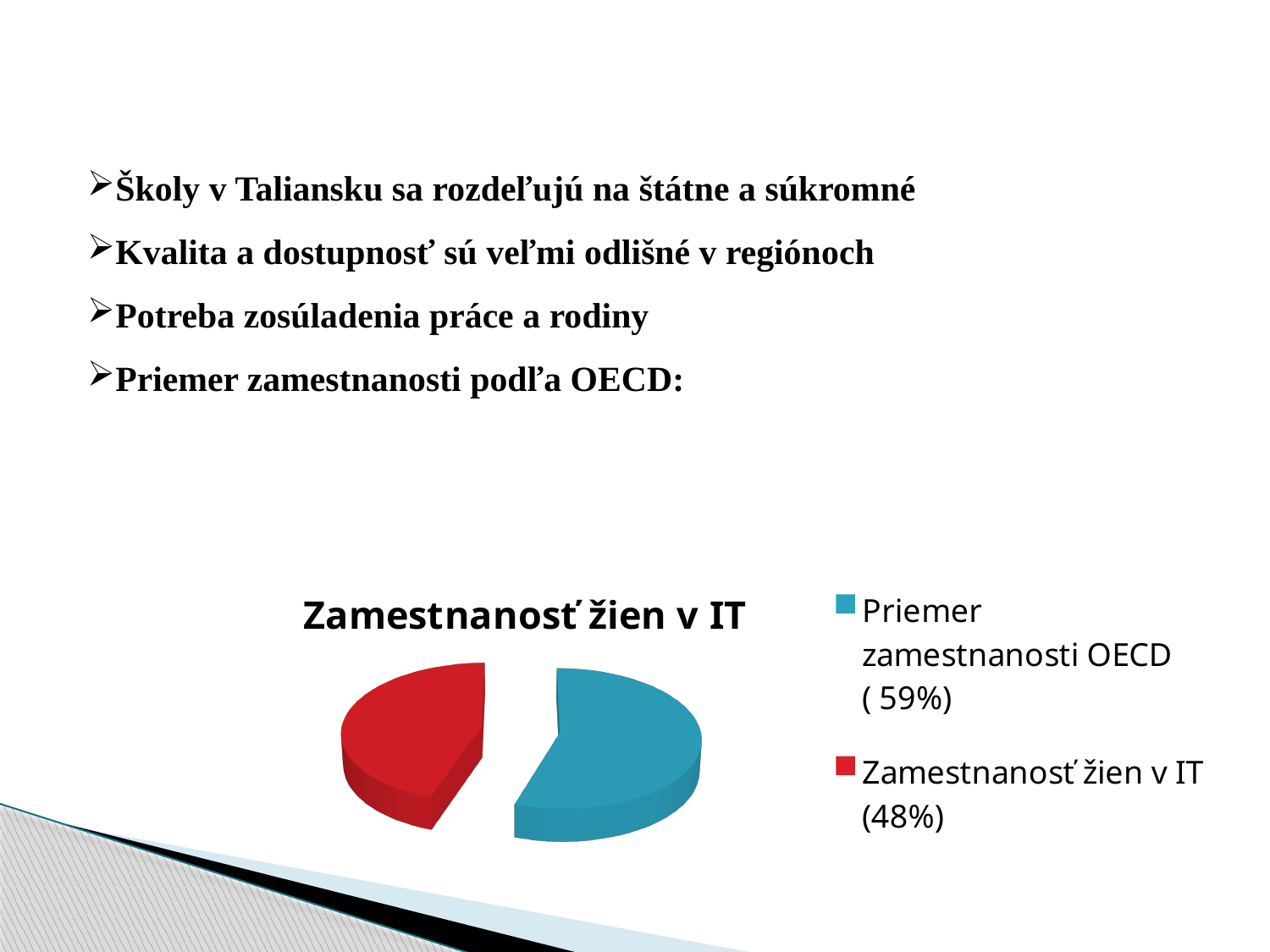
Which slice of the pie chart is the largest? Priemer zamestnanosti OECD What percentage is given in the legend for "Priemer zamestnanosti OECD"? 59% What percentage is given in the legend for "Zamestnanosť žien v IT"? 48% What is the title of the chart? Zamestnanosť žien v IT Which slice of the pie chart is the smallest? Zamestnanosť žien v IT Which legend entry has the larger value, "Priemer zamestnanosti OECD" or "Zamestnanosť žien v IT"? Priemer zamestnanosti OECD What colour is the slice for "Zamestnanosť žien v IT"? red How many slices does the pie chart have? 2 What kind of chart is shown on the slide? pie chart What is the difference in percentage points between "Priemer zamestnanosti OECD" (59%) and "Zamestnanosť žien v IT" (48%)? 11 How many entries does the chart legend list? 2